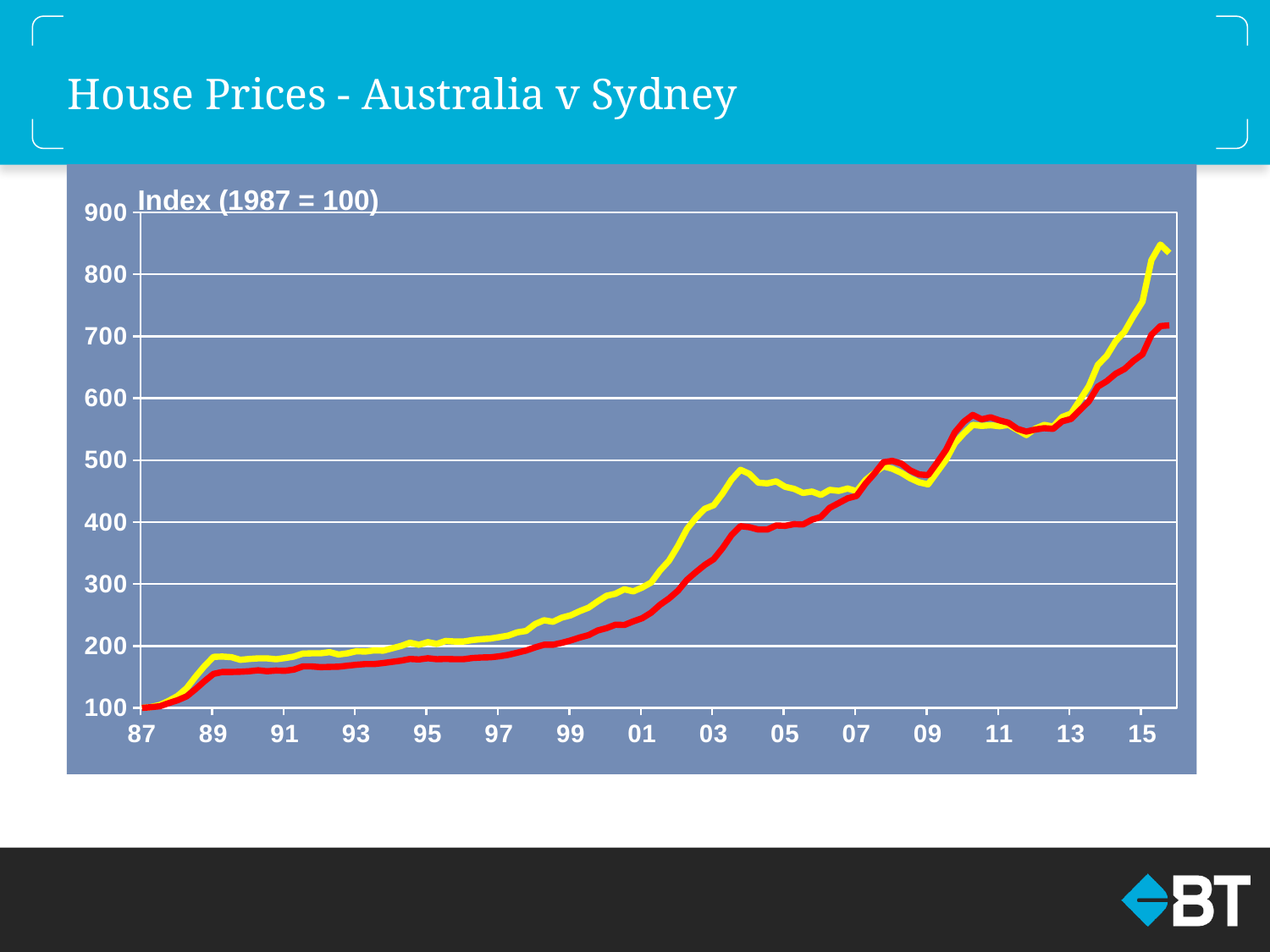
Is the value of the red line at 15 greater or less than 800? less What is the title of the chart? House Prices - Australia v Sydney What is the index value of both lines at 87? 100 At 15, which line has the higher value, the yellow line or the red line? yellow line How many lines are plotted on the chart? 2 Is the value of the red line at 03 greater or less than 400? less At 03, which line has the higher value, the yellow line or the red line? yellow line Is the value of the yellow line at 89 greater or less than 200? less What label is shown above the y axis of the chart? Index (1987 = 100) What kind of chart is shown on the slide? line chart Do the values of the yellow line generally rise or fall from 87 to 15? rise